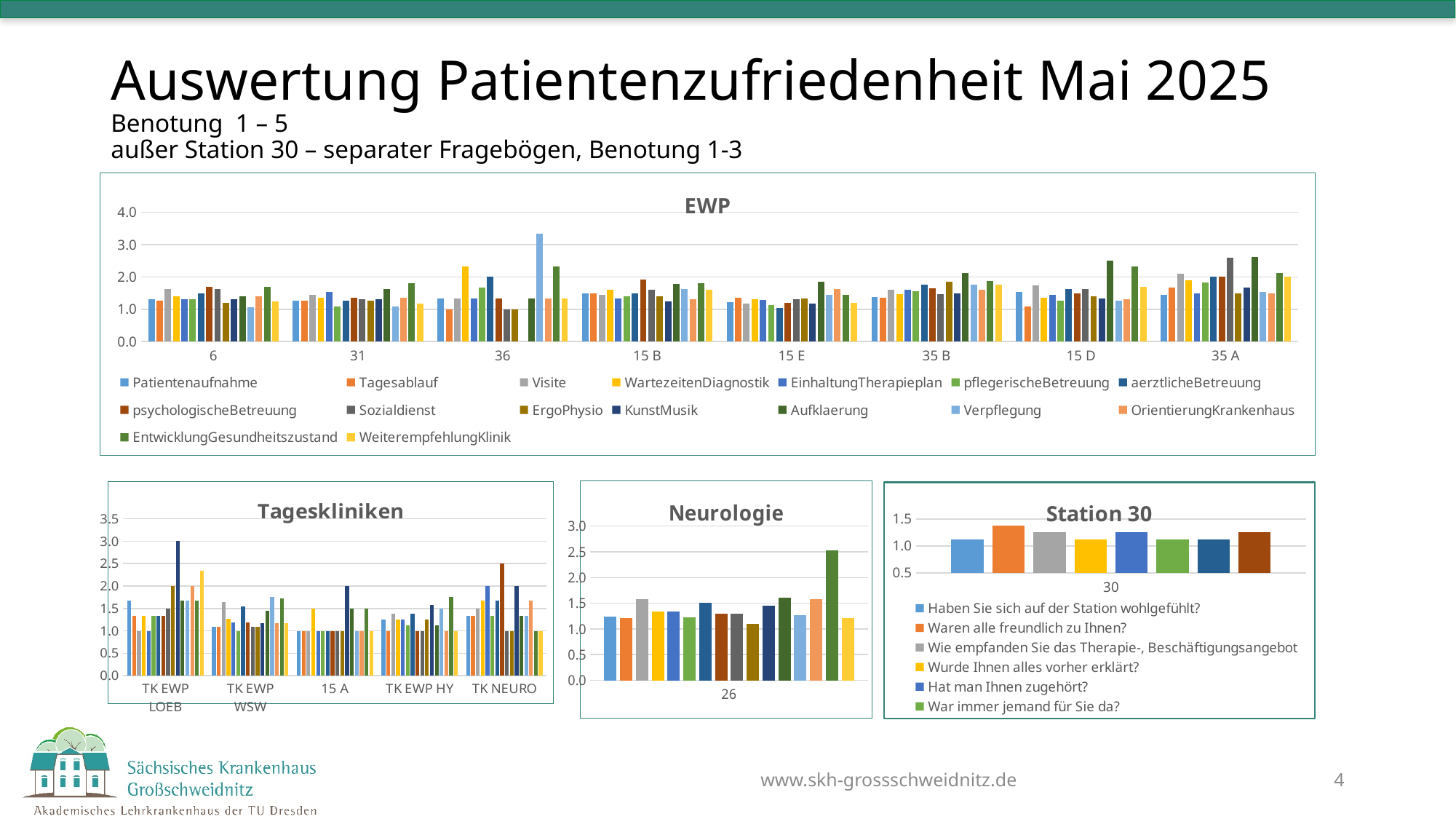
What kind of chart is the EWP chart? bar chart How many categories are shown on the x axis of the Tageskliniken chart? 5 In the Station 30 chart, is the value for "Waren alle freundlich zu Ihnen?" greater or less than 1.0? greater In the Neurologie chart, is the tallest bar greater or less than 2.0? greater In the Tageskliniken chart, which category contains the tallest bar? TK EWP LOEB In the Tageskliniken chart, is the tallest bar greater or less than 2.5? greater In the Station 30 chart, which series has the highest bar? Waren alle freundlich zu Ihnen? How many series does the legend of the EWP chart list? 16 How many categories are shown on the x axis of the EWP chart? 8 What is the only category label on the x axis of the Neurologie chart? 26 In the EWP chart, which category contains the tallest bar? 36